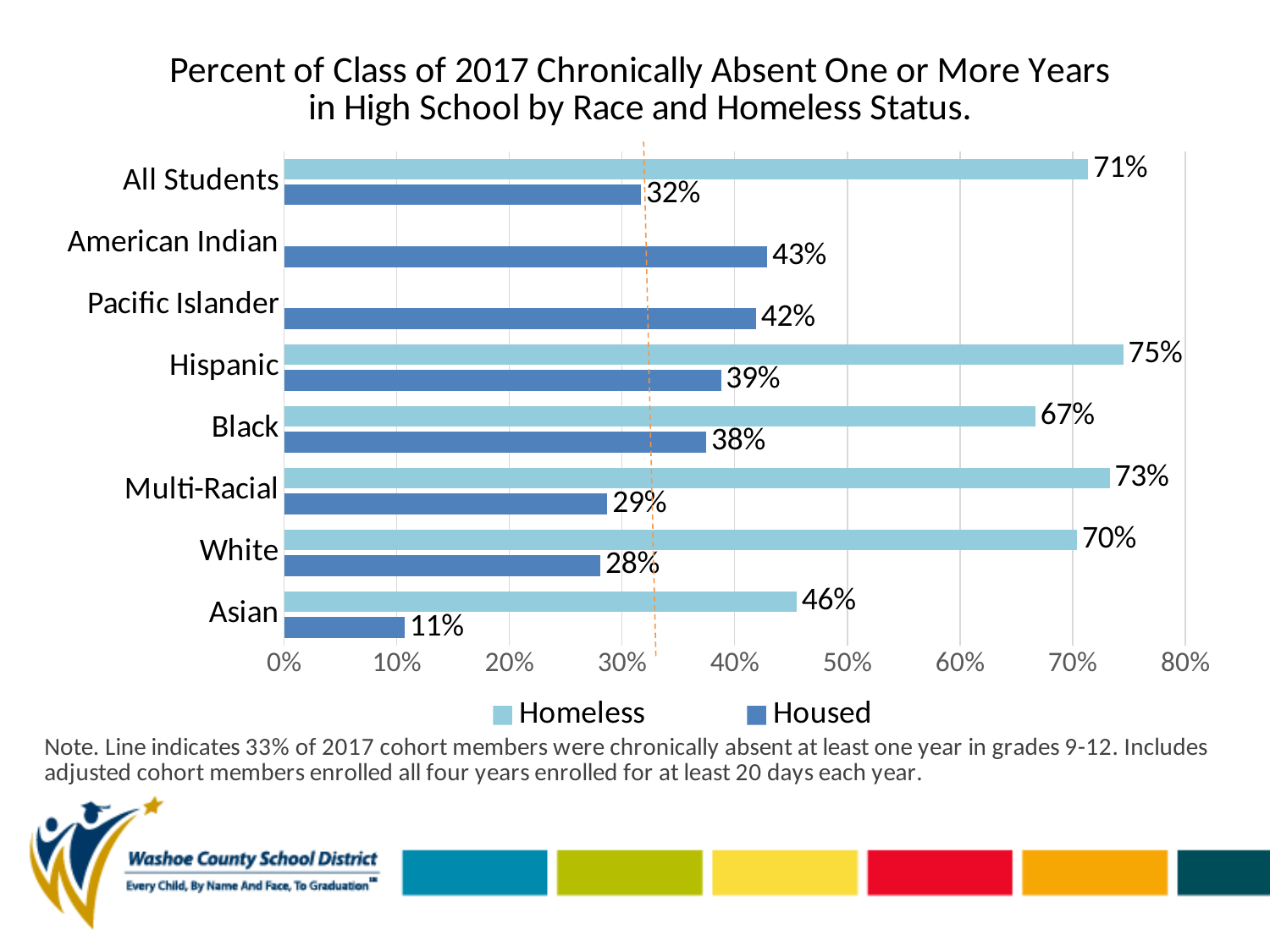
Is the Homeless value for Asian students greater or less than 40%? greater According to the note, what percentage does the dashed line indicate? 33% Which is larger, the Housed value for Black students or the Housed value for Multi-Racial students? Black What is the Housed value for Asian students? 11% What is the Homeless value for Hispanic students? 75% Which category has the lowest Housed value? Asian How many series does the legend list? 2 How many categories are shown on the y axis? 8 What is the difference between the Homeless and Housed values for All Students? 39% What is the Housed value for American Indian students? 43% What kind of chart is shown on the slide? Bar chart Which category has the highest Homeless value? Hispanic